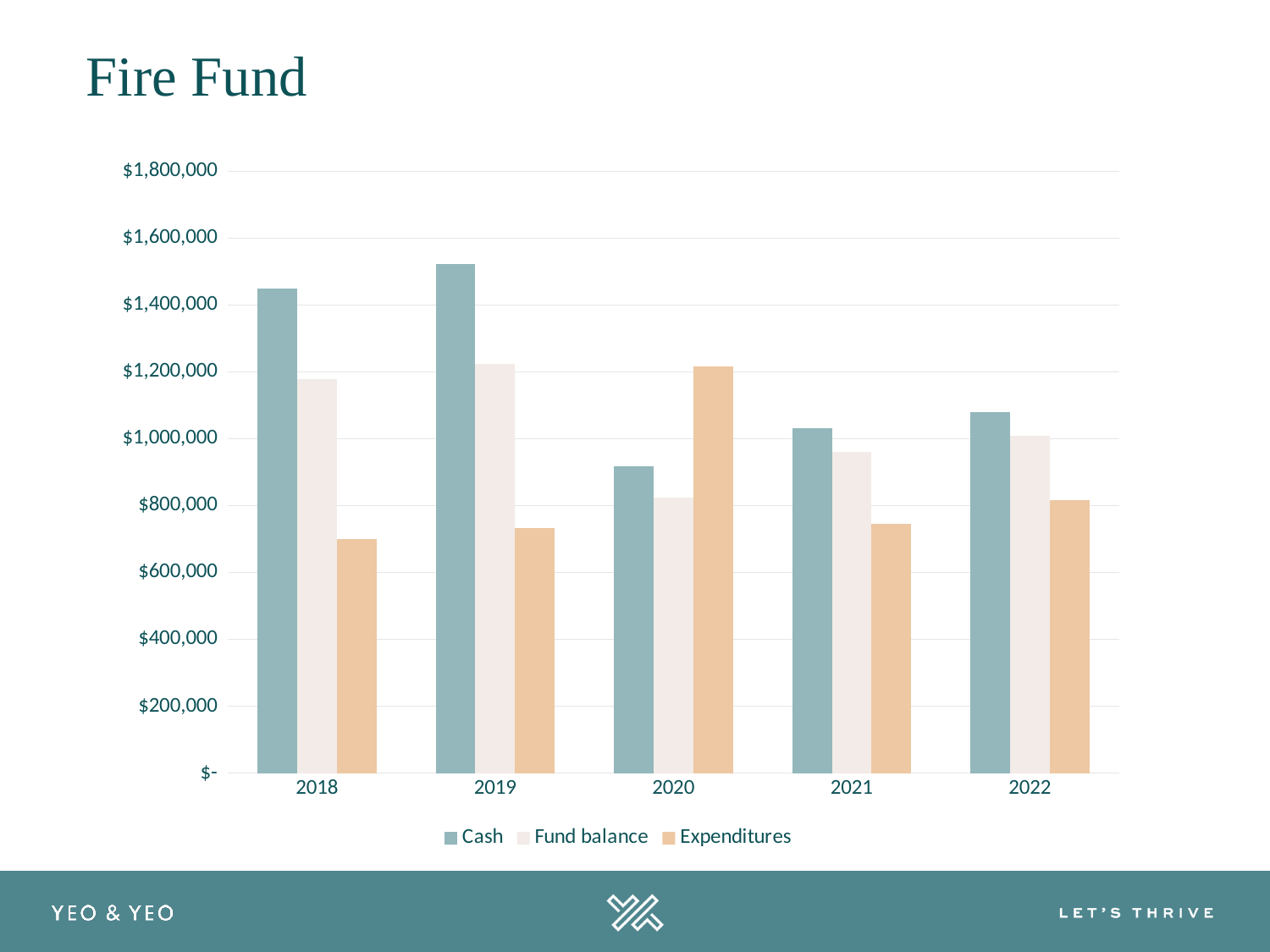
In which year are Expenditures the highest? 2020 How many years are shown on the x axis? 5 In which year is Cash the highest? 2019 Do Expenditures rise or fall from 2018 to 2020? rise In which year is Cash the lowest? 2020 Is the Fund balance value for 2020 greater or less than $1,000,000? less Is the Cash value for 2018 greater or less than $1,400,000? greater What kind of chart is shown on the slide? bar chart What is the title of the slide? Fire Fund How many series does the legend list? 3 In 2020, which is larger: Cash or Expenditures? Expenditures Is the Expenditures value for 2018 greater or less than $800,000? less